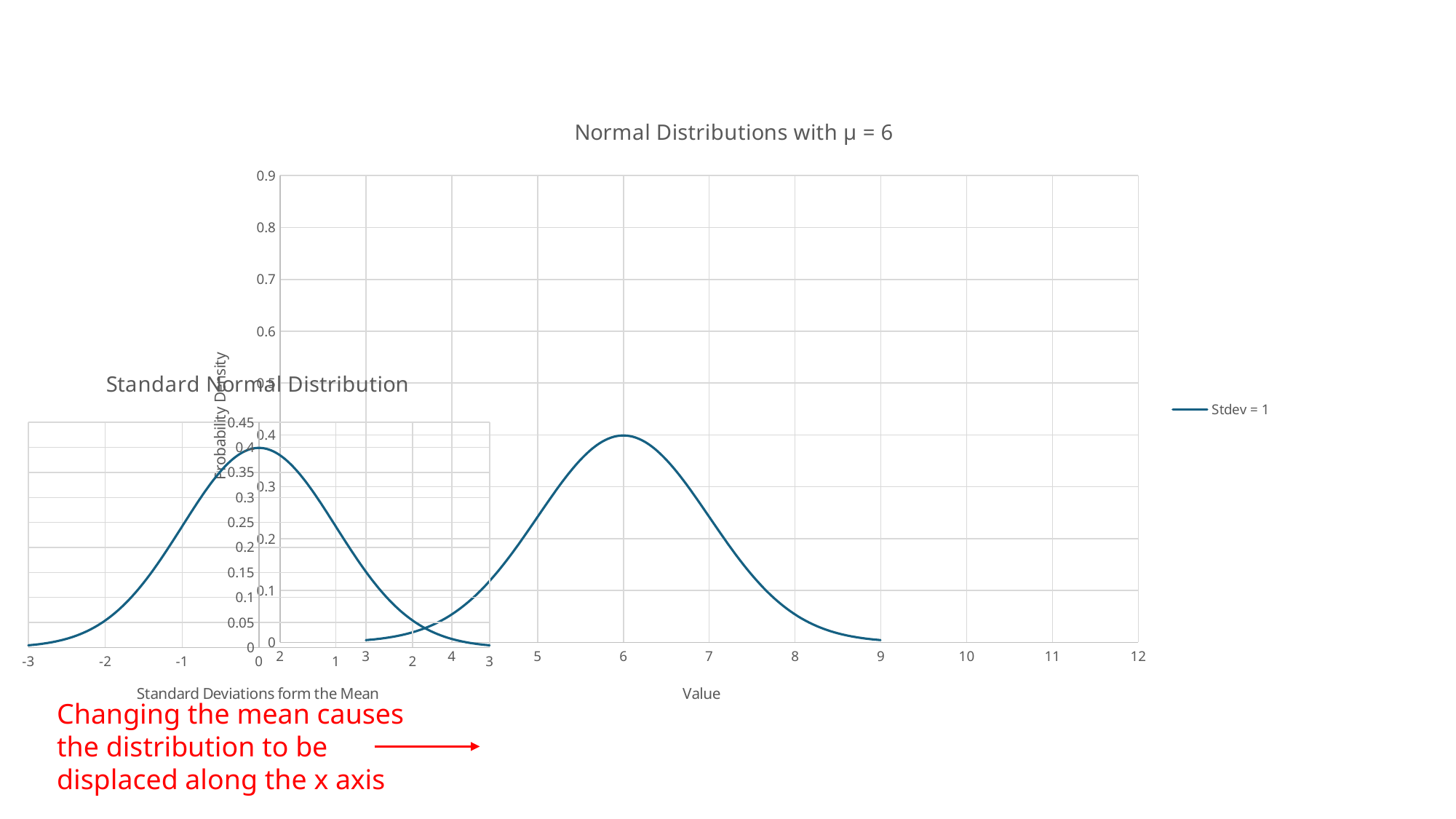
In the 'Normal Distributions with μ = 6' chart, what is the legend entry for the plotted series? Stdev = 1 What kind of chart is the 'Standard Normal Distribution' chart? line chart In the 'Normal Distributions with μ = 6' chart, does the curve rise or fall as x goes from 6 to 9? fall What is the x-axis title of the 'Normal Distributions with μ = 6' chart? Value In the 'Normal Distributions with μ = 6' chart, how many series does the legend list? 1 In the 'Standard Normal Distribution' chart, at which x-axis value does the curve reach its peak? 0 In the 'Normal Distributions with μ = 6' chart, is the peak value of the curve greater or less than 0.5? less In the 'Normal Distributions with μ = 6' chart, at which x-axis value does the curve reach its peak? 6 In the 'Normal Distributions with μ = 6' chart, is the peak value of the curve greater or less than 0.3? greater What kind of chart is the 'Normal Distributions with μ = 6' chart? line chart In the 'Normal Distributions with μ = 6' chart, is the value of the curve at x = 9 greater or less than 0.1? less In the 'Normal Distributions with μ = 6' chart, which is larger: the curve's value at x = 6 or at x = 8? x = 6